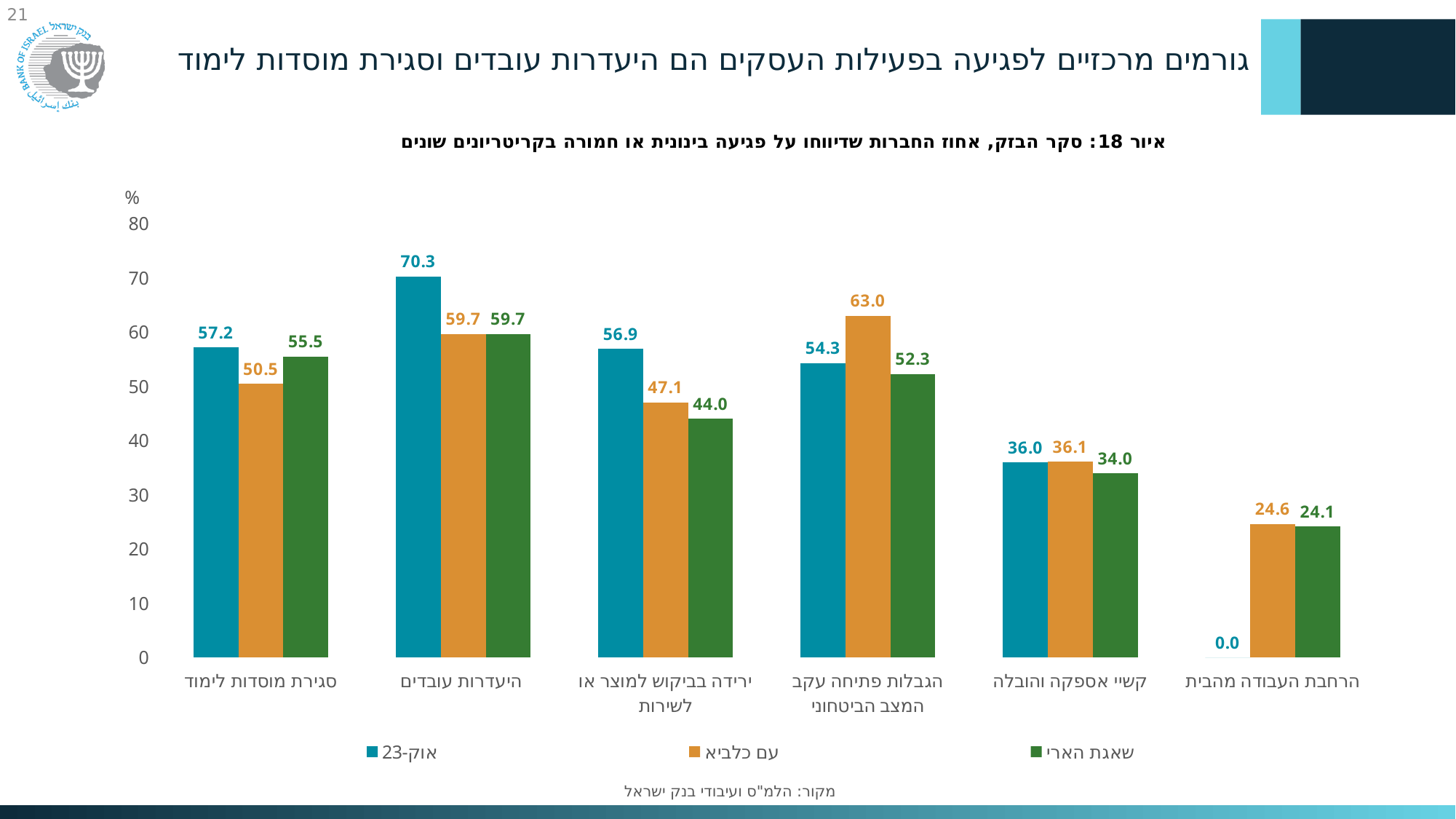
Which category has the highest value in the אוק-23 series? היעדרות עובדים How many series does the legend list? 3 How many categories are shown on the x axis? 6 For הגבלות פתיחה עקב המצב הביטחוני, which series has the larger value: אוק-23 or שאגת הארי? אוק-23 Which category has the lowest value in the עם כלביא series? הרחבת העבודה מהבית What is the value for היעדרות עובדים in the אוק-23 series? 70.3 What is the difference between the אוק-23 and עם כלביא values for סגירת מוסדות לימוד? 6.7 What kind of chart is shown on the slide? bar chart What is the value for הגבלות פתיחה עקב המצב הביטחוני in the עם כלביא series? 63.0 What is the value for הרחבת העבודה מהבית in the אוק-23 series? 0.0 What is the value for ירידה בביקוש למוצר או לשירות in the שאגת הארי series? 44.0 Is the value for קשיי אספקה והובלה in the שאגת הארי series greater or less than 40? less